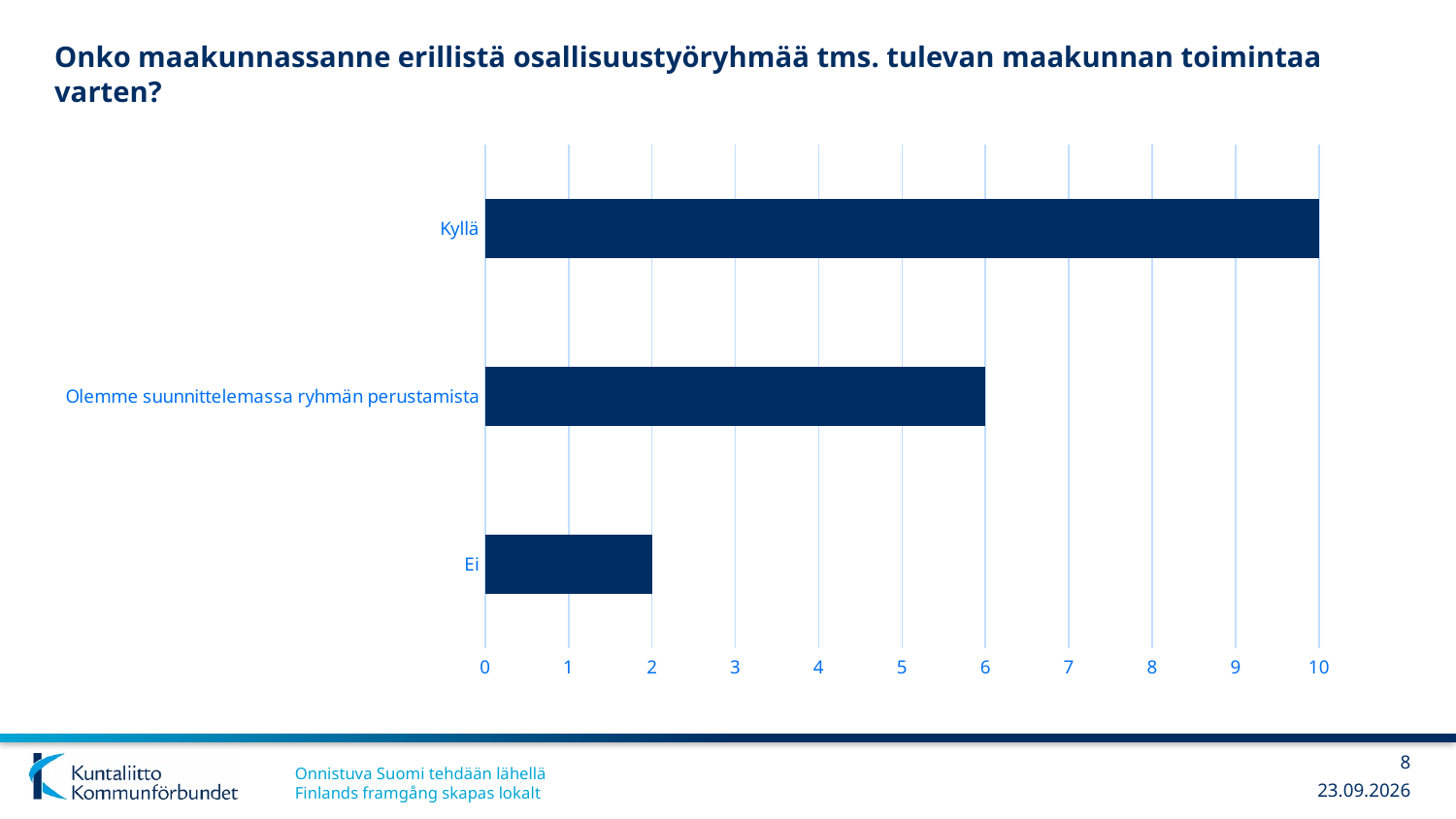
Which category has the lowest value? Ei What is the highest value shown on the horizontal axis? 10 What kind of chart is shown on the slide? bar chart Which category has the highest value? Kyllä How many categories are shown in the chart? 3 Which is larger, the value for Olemme suunnittelemassa ryhmän perustamista or the value for Ei? Olemme suunnittelemassa ryhmän perustamista What is the value for Kyllä? 10 What is the difference between the values for Kyllä and Ei? 8 What is the value for Ei? 2 What is the difference between the values for Kyllä and Olemme suunnittelemassa ryhmän perustamista? 4 What is the value for Olemme suunnittelemassa ryhmän perustamista? 6 Is the value for Olemme suunnittelemassa ryhmän perustamista greater or less than 5? greater